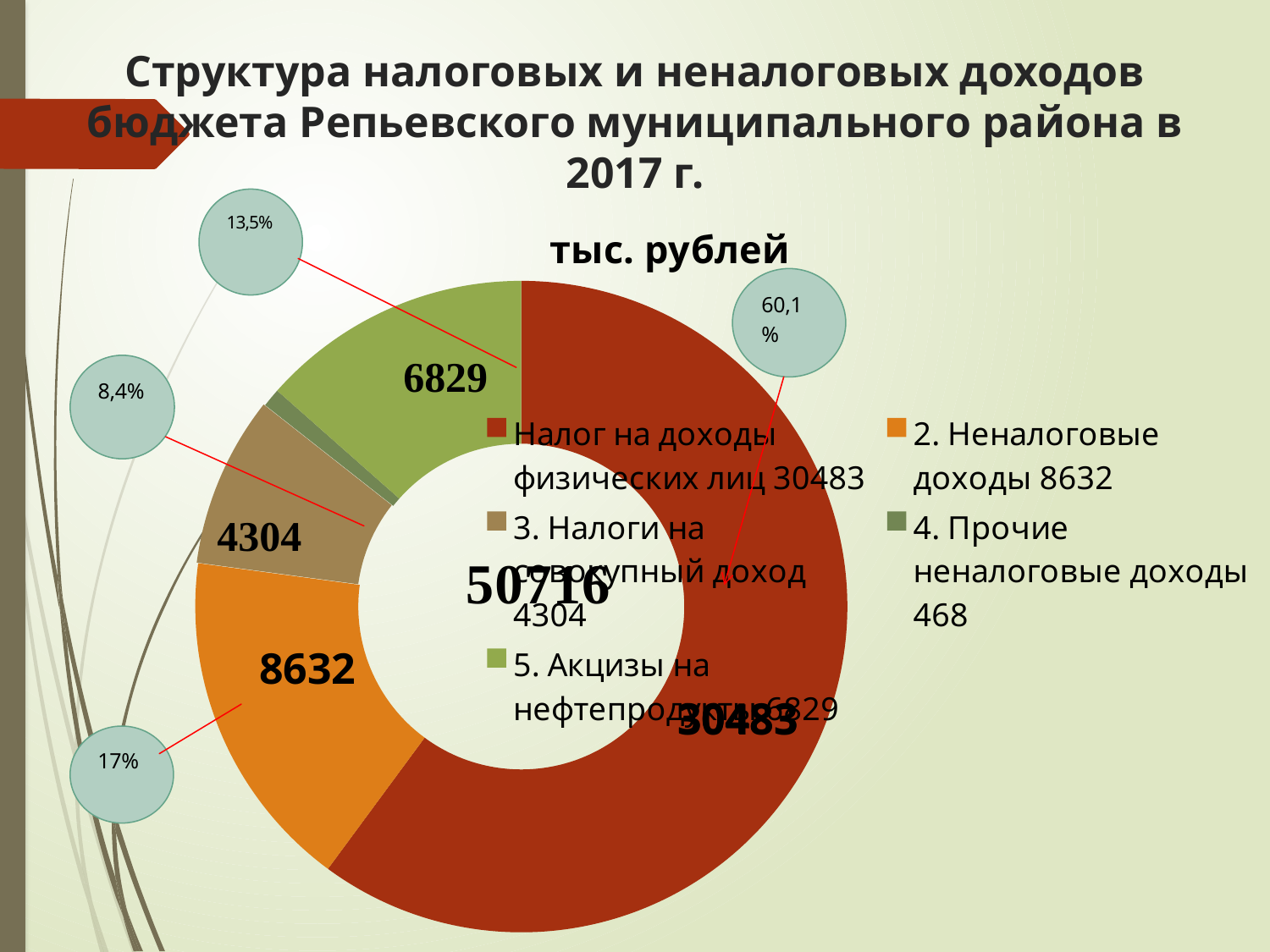
How many categories does the legend list? 5 What is the value for "4. Прочие неналоговые доходы"? 468 What is the value for "3. Налоги на совокупный доход"? 4304 What kind of chart is shown on the slide? doughnut chart What is the value for "5. Акцизы на нефтепродукты"? 6829 What is the value for "Налог на доходы физических лиц"? 30483 What is the difference between the values for "2. Неналоговые доходы" and "3. Налоги на совокупный доход"? 4328 What is the value for "2. Неналоговые доходы"? 8632 Which category has the largest value? Налог на доходы физических лиц Which is larger: the value for "5. Акцизы на нефтепродукты" or the value for "2. Неналоговые доходы"? 2. Неналоговые доходы Which category has the smallest value? 4. Прочие неналоговые доходы What total is printed in the centre of the doughnut chart? 50716